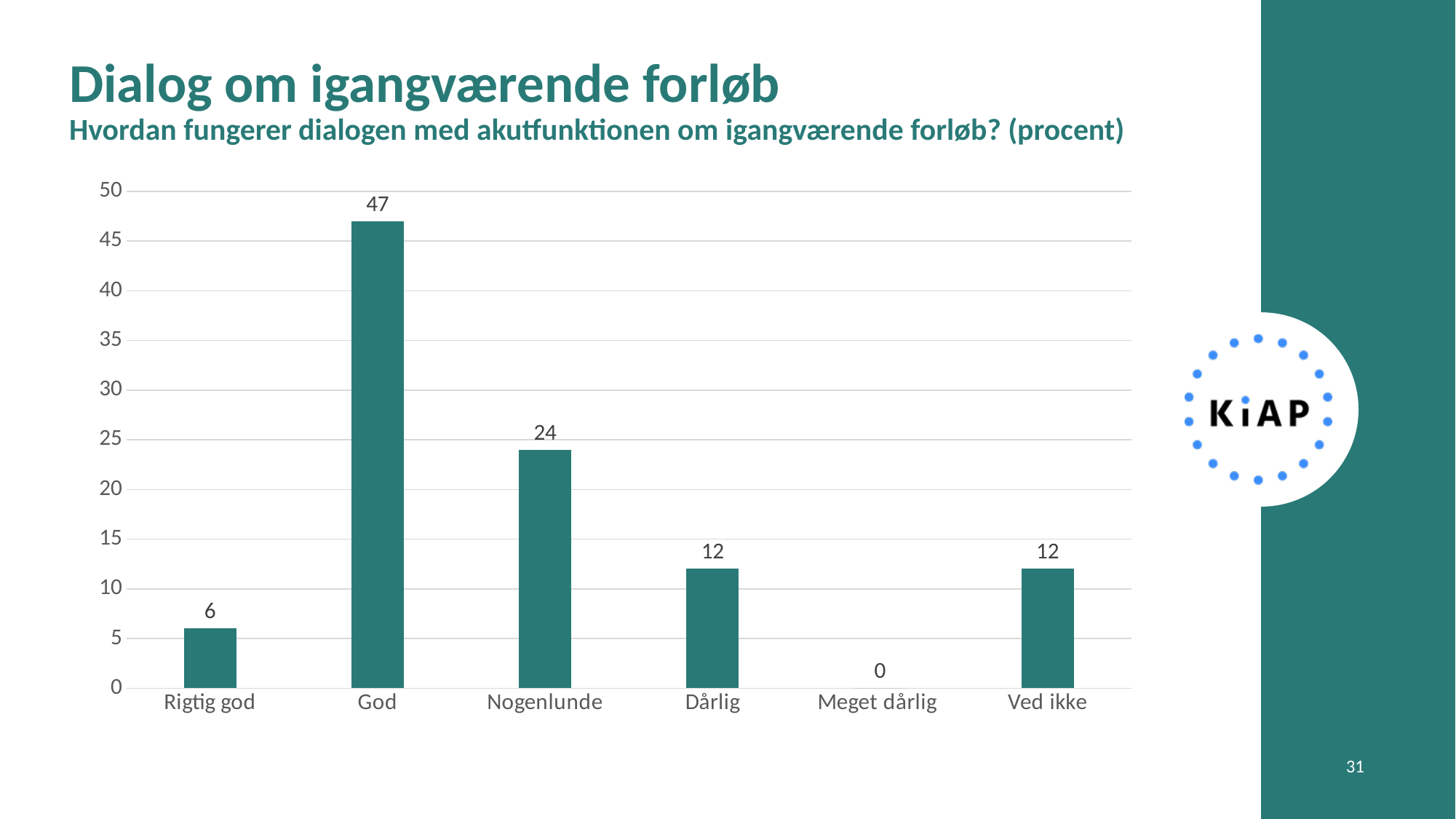
Is the value for Nogenlunde greater or less than 20? greater What is the title of the slide? Dialog om igangværende forløb What is the value for God? 47 Which category has the lowest value? Meget dårlig What is the value for Rigtig god? 6 What kind of chart is shown on the slide? bar chart Which is larger, the value for Rigtig god or the value for Dårlig? Dårlig Which category has the highest value? God What is the value for Nogenlunde? 24 What is the value for Meget dårlig? 0 What is the difference between the values for God and Nogenlunde? 23 How many categories are shown on the x axis? 6